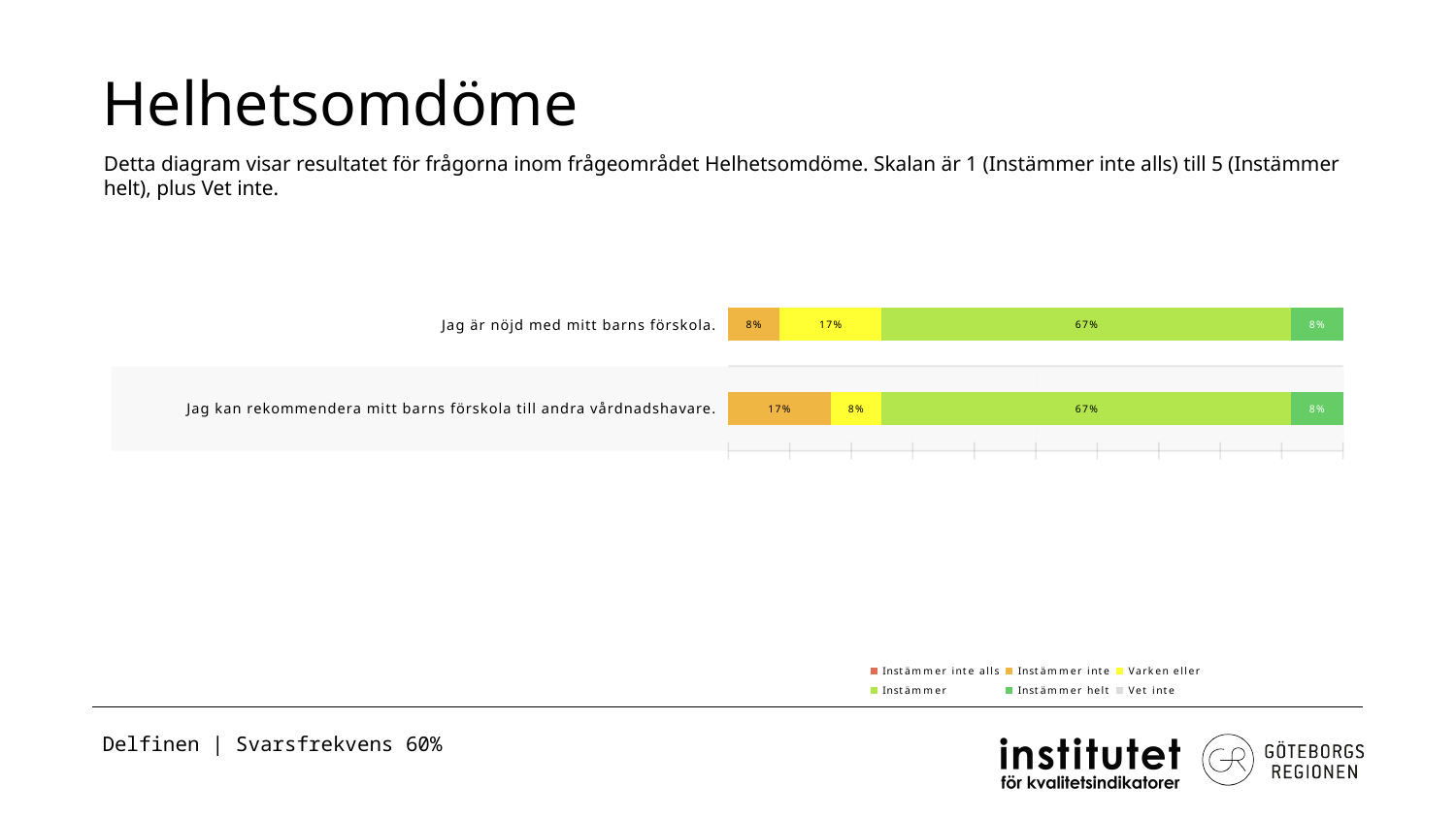
What is the difference between the 'Varken eller' share for 'Jag är nöjd med mitt barns förskola.' and the 'Varken eller' share for 'Jag kan rekommendera mitt barns förskola till andra vårdnadshavare.'? 9% How many statements (categories) are plotted in the chart? 2 What is the 'Varken eller' share for 'Jag är nöjd med mitt barns förskola.'? 17% Which response option has the largest share for 'Jag är nöjd med mitt barns förskola.'? Instämmer What is the 'Instämmer helt' share for 'Jag kan rekommendera mitt barns förskola till andra vårdnadshavare.'? 8% What is the total of the labelled segments in the bar for 'Jag är nöjd med mitt barns förskola.'? 100% What kind of chart is shown on the slide? Stacked bar chart Which statement has the larger 'Instämmer inte' share? Jag kan rekommendera mitt barns förskola till andra vårdnadshavare. What is the title of the slide containing the chart? Helhetsomdöme What is the 'Instämmer inte' share for 'Jag kan rekommendera mitt barns förskola till andra vårdnadshavare.'? 17% What is the 'Instämmer' share for 'Jag är nöjd med mitt barns förskola.'? 67% How many series does the legend list? 6